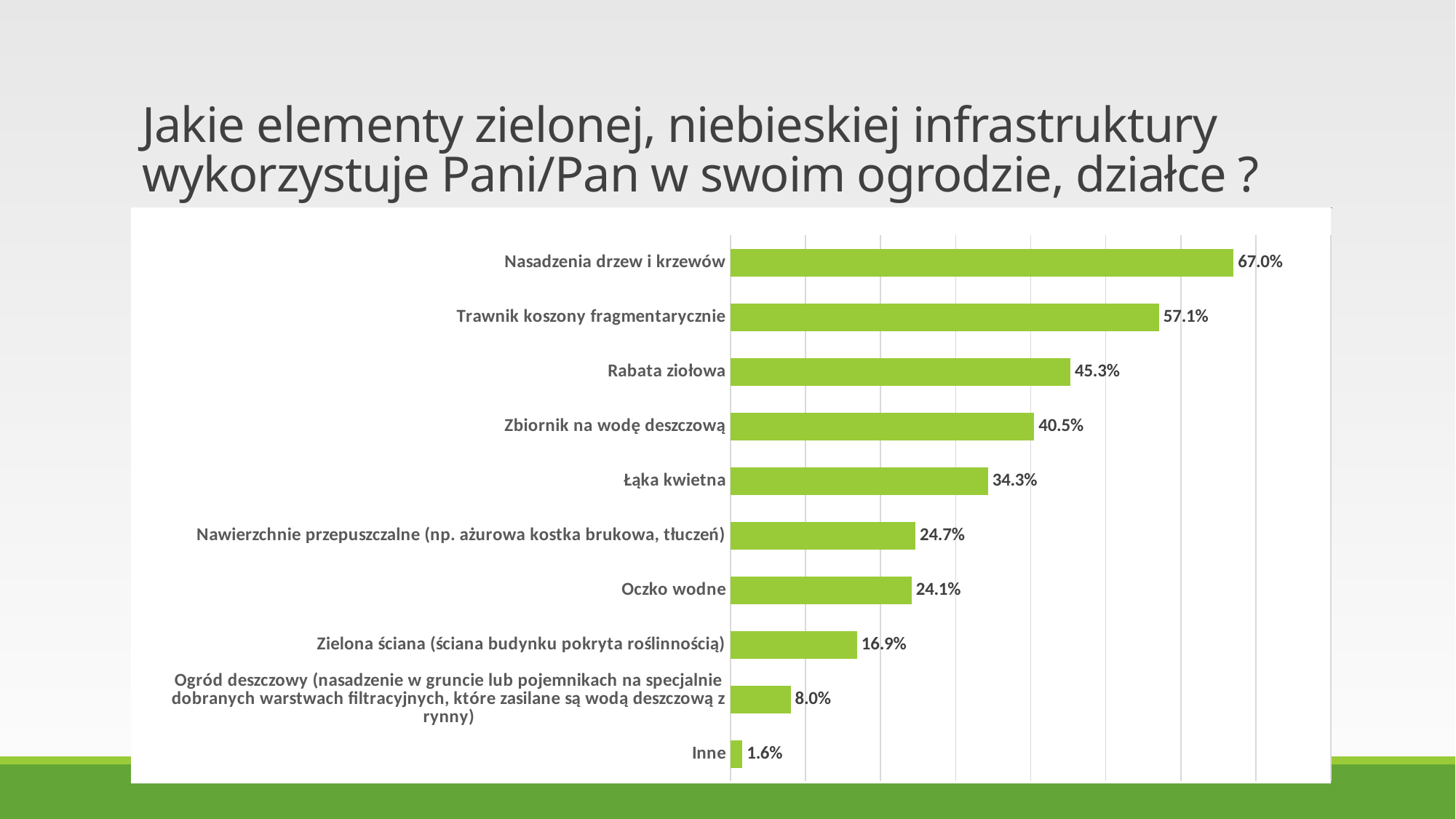
Which category has the highest value? Nasadzenia drzew i krzewów Which category has the lowest value? Inne What percentage of respondents use 'Nasadzenia drzew i krzewów'? 67.0% What is the value shown for 'Zielona ściana (ściana budynku pokryta roślinnością)'? 16.9% What kind of chart is shown on the slide? Bar chart What colour are the bars in the chart? Green Which is larger: the value for 'Rabata ziołowa' or the value for 'Łąka kwietna'? Rabata ziołowa What is the value shown for 'Zbiornik na wodę deszczową'? 40.5% How many categories are shown in the chart? 10 What is the difference between the values for 'Trawnik koszony fragmentarycznie' and 'Rabata ziołowa'? 11.8% Which is larger: the value for 'Ogród deszczowy' or the value for 'Zielona ściana'? Zielona ściana What is the difference between the values for 'Łąka kwietna' and 'Oczko wodne'? 10.2%